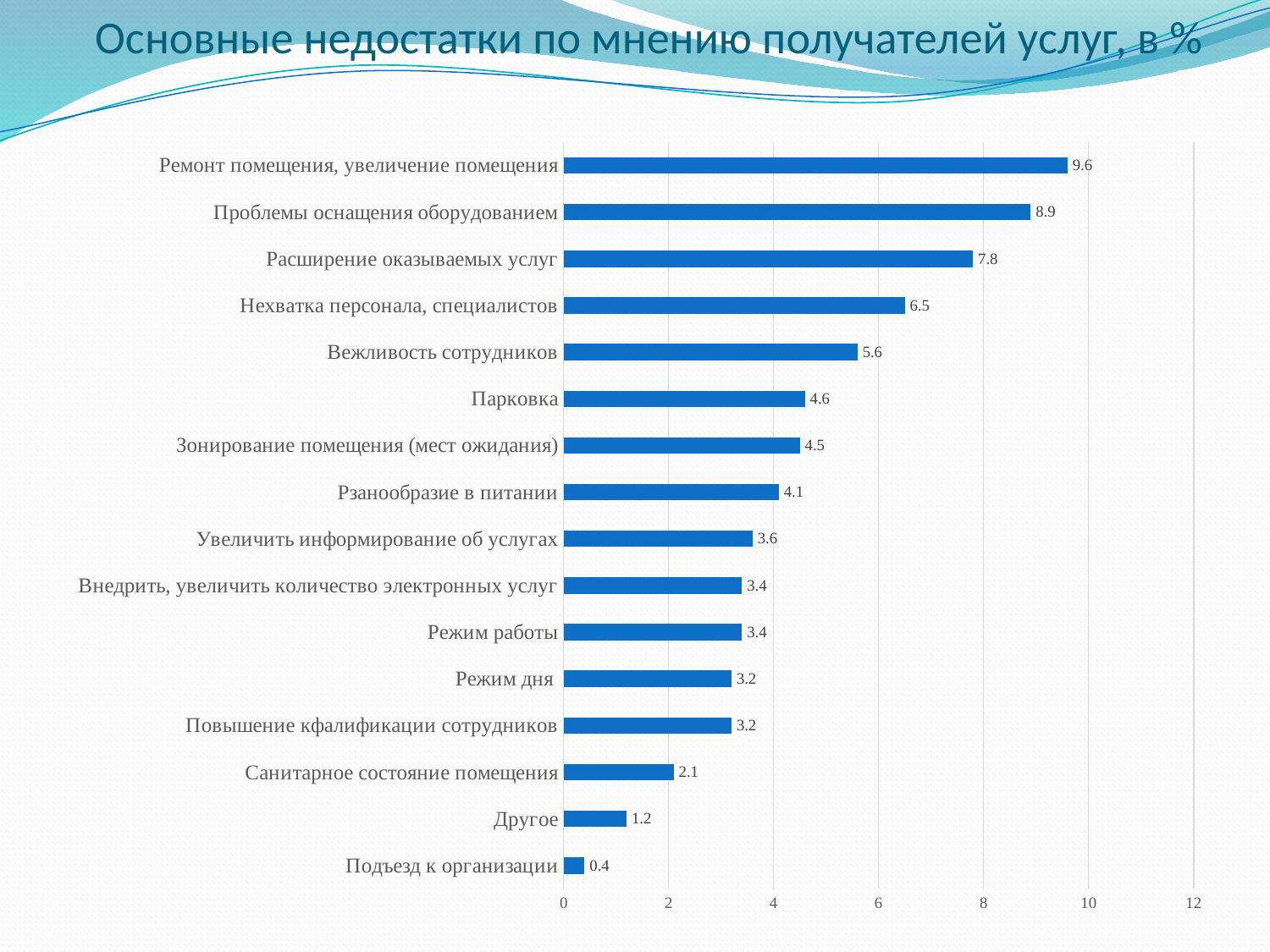
What is the title of the slide? Основные недостатки по мнению получателей услуг, в % Which is larger, the value for "Расширение оказываемых услуг" or the value for "Зонирование помещения (мест ожидания)"? Расширение оказываемых услуг Which category has the lowest value? Подъезд к организации Is the value for "Проблемы оснащения оборудованием" greater or less than 8? greater What is the value for "Нехватка персонала, специалистов"? 6.5 What is the difference between the values for "Ремонт помещения, увеличение помещения" and "Проблемы оснащения оборудованием"? 0.7 What is the difference between the values for "Вежливость сотрудников" and "Другое"? 4.4 Which category has the highest value? Ремонт помещения, увеличение помещения What is the value for "Парковка"? 4.6 How many categories are shown in the chart? 16 What is the value for "Санитарное состояние помещения"? 2.1 What kind of chart is shown on the slide? bar chart